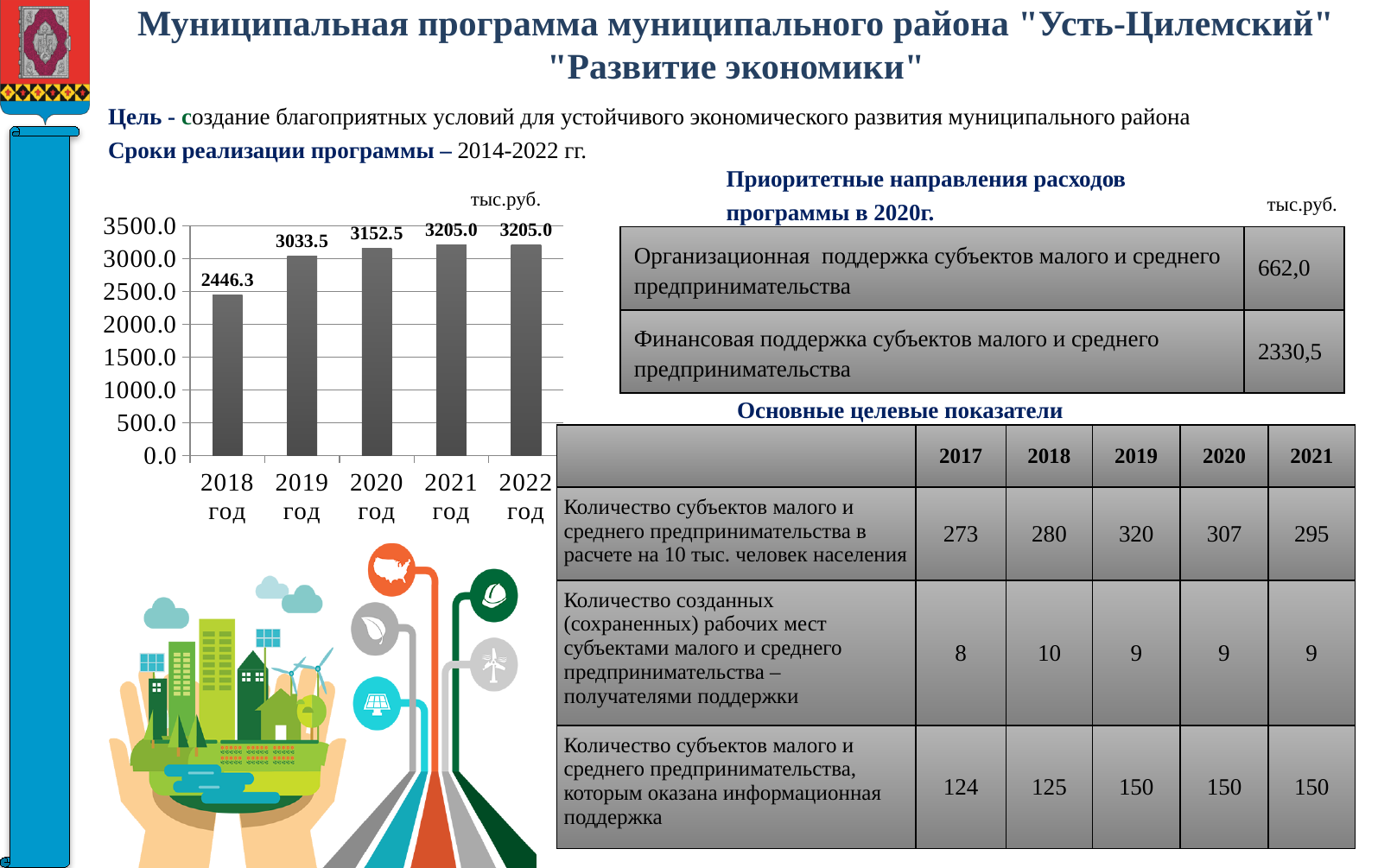
What is the difference between the values for 2021 год and 2020 год in the bar chart? 52.5 Is the value for 2021 год in the bar chart greater or less than 3000.0? greater What is the difference between the values for 2019 год and 2018 год in the bar chart? 587.2 Which year has the lowest value in the bar chart? 2018 год How many years are shown on the x axis of the bar chart? 5 What kind of chart is shown on the left of the slide? bar chart What is the value for 2019 год in the bar chart? 3033.5 Which is larger in the bar chart, the value for 2020 год or the value for 2019 год? 2020 год Is the value for 2018 год in the bar chart greater or less than 2500.0? less Do the values in the bar chart generally rise or fall from 2018 год to 2022 год? rise What is the value for 2018 год in the bar chart? 2446.3 What is the value for 2020 год in the bar chart? 3152.5